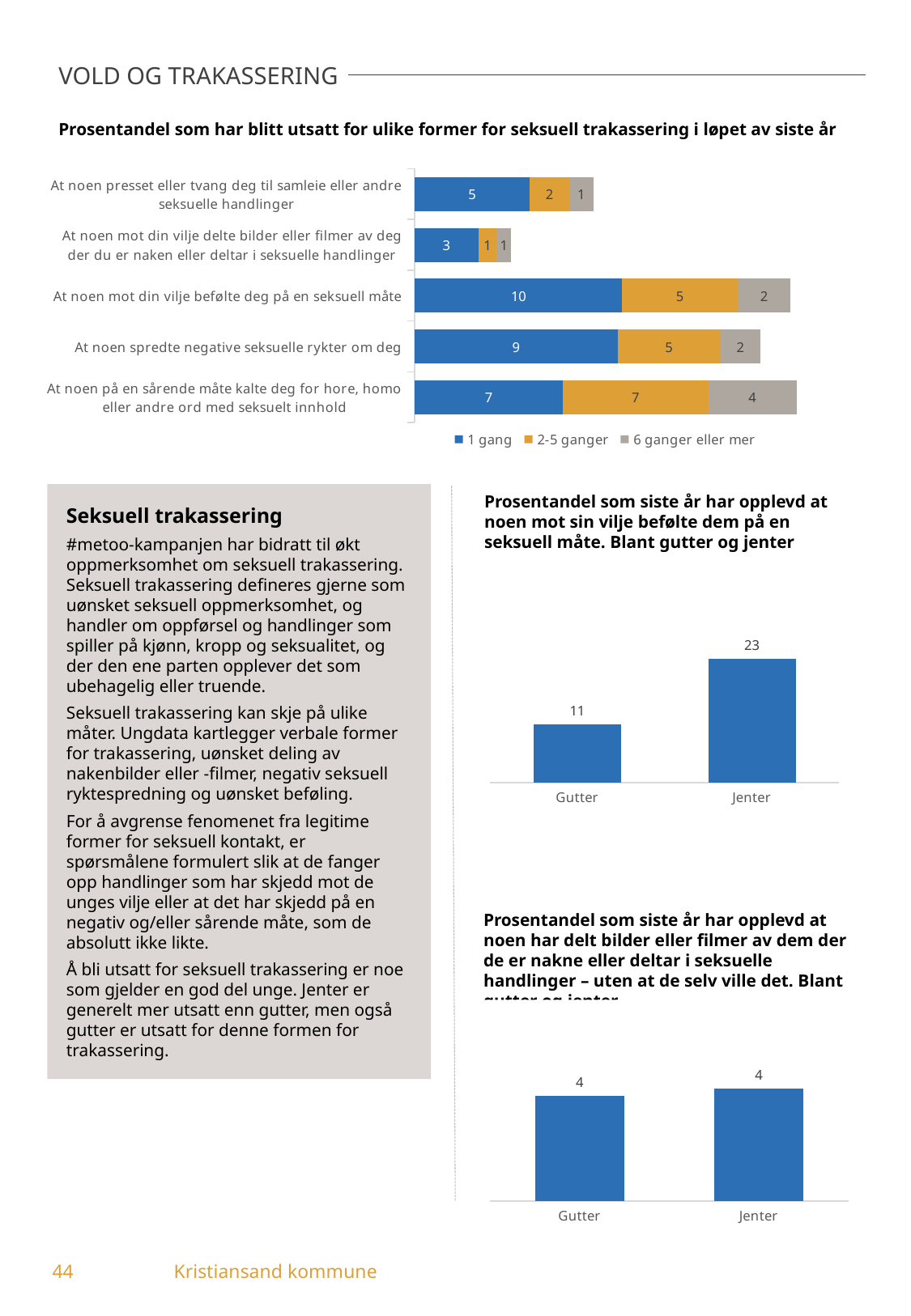
In the top chart, which category has the highest '1 gang' value? At noen mot din vilje befølte deg på en seksuell måte In the bottom chart about 'delt bilder eller filmer', which is larger, Gutter or Jenter? They are equal (4) What kind of chart is the top chart on the slide? Stacked bar chart In the top chart, how many categories are shown? 5 In the top chart, what is the '6 ganger eller mer' value for 'At noen på en sårende måte kalte deg for hore, homo eller andre ord med seksuelt innhold'? 4 In the top chart, what is the total of the stacked bar for 'At noen mot din vilje delte bilder eller filmer av deg der du er naken eller deltar i seksuelle handlinger'? 5 In the top chart, what is the difference between the '2-5 ganger' values for 'At noen på en sårende måte kalte deg for hore, homo eller andre ord med seksuelt innhold' and 'At noen presset eller tvang deg til samleie eller andre seksuelle handlinger'? 5 In the top chart, how many series does the legend list? 3 In the middle chart about 'befølte dem på en seksuell måte', what is the difference between Jenter and Gutter? 12 In the top chart, what is the total of the stacked bar for 'At noen spredte negative seksuelle rykter om deg'? 16 In the middle chart 'Prosentandel som siste år har opplevd at noen mot sin vilje befølte dem på en seksuell måte', what is the value for Jenter? 23 In the top chart 'Prosentandel som har blitt utsatt for ulike former for seksuell trakassering i løpet av siste år', what is the '1 gang' value for 'At noen mot din vilje befølte deg på en seksuell måte'? 10